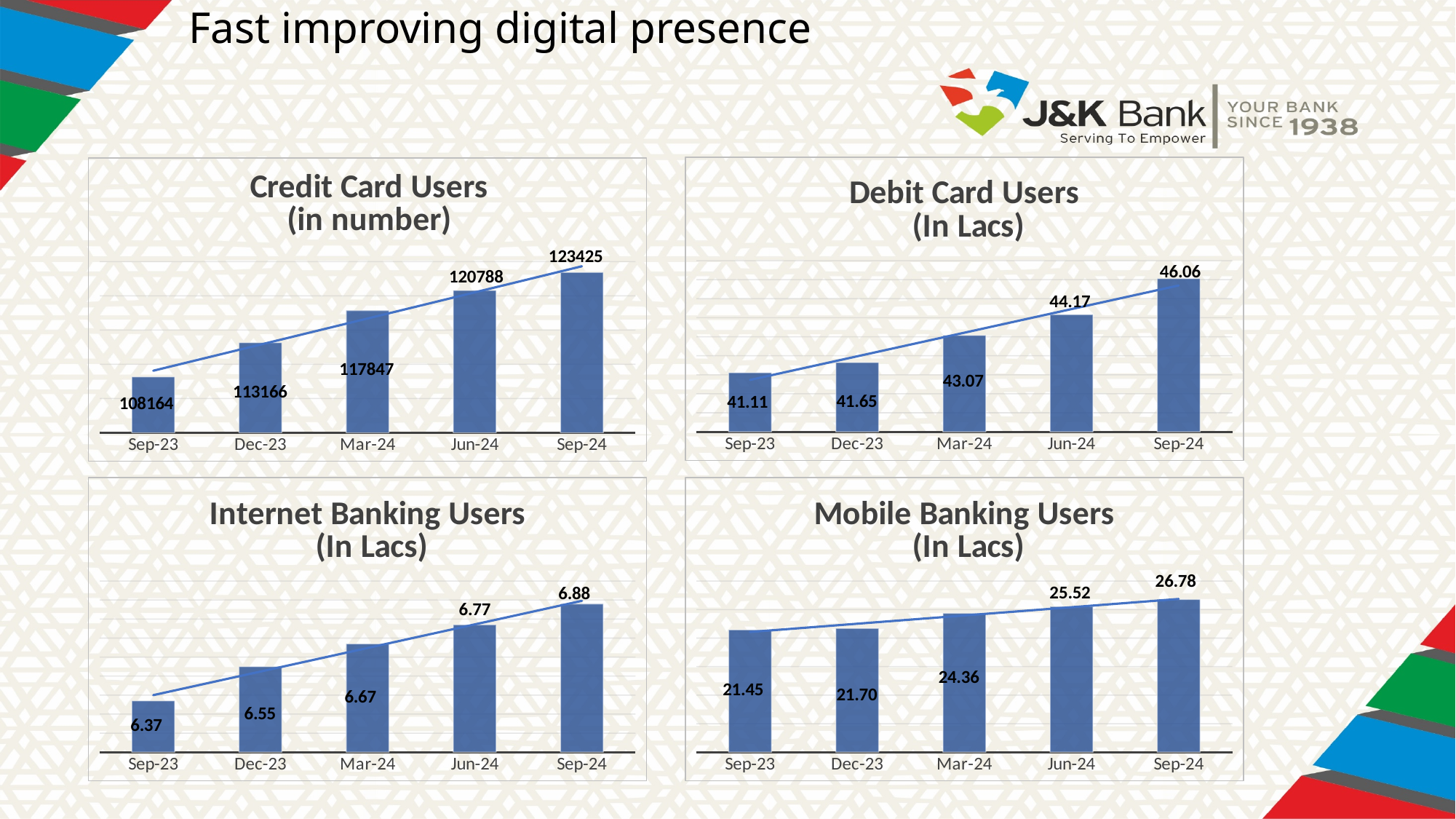
In the Internet Banking Users chart, which is larger, the value for Mar-24 or the value for Jun-24? Jun-24 What kind of chart is the Mobile Banking Users chart? Bar chart In the Debit Card Users chart, what is the value for Mar-24? 43.07 In the Internet Banking Users chart, what is the value for Dec-23? 6.55 In the Internet Banking Users chart, do the values rise or fall from Sep-23 to Sep-24? Rise In the Debit Card Users chart, what is the difference between the Sep-24 and Sep-23 values? 4.95 In the Mobile Banking Users chart, which period has the highest value? Sep-24 In the Credit Card Users chart, what is the value for Sep-24? 123425 In the Credit Card Users chart, what is the difference between the Jun-24 and Mar-24 values? 2941 In the Mobile Banking Users chart, what is the value for Jun-24? 25.52 How many periods are shown on the x axis of the Debit Card Users chart? 5 In the Credit Card Users chart, which period has the lowest value? Sep-23